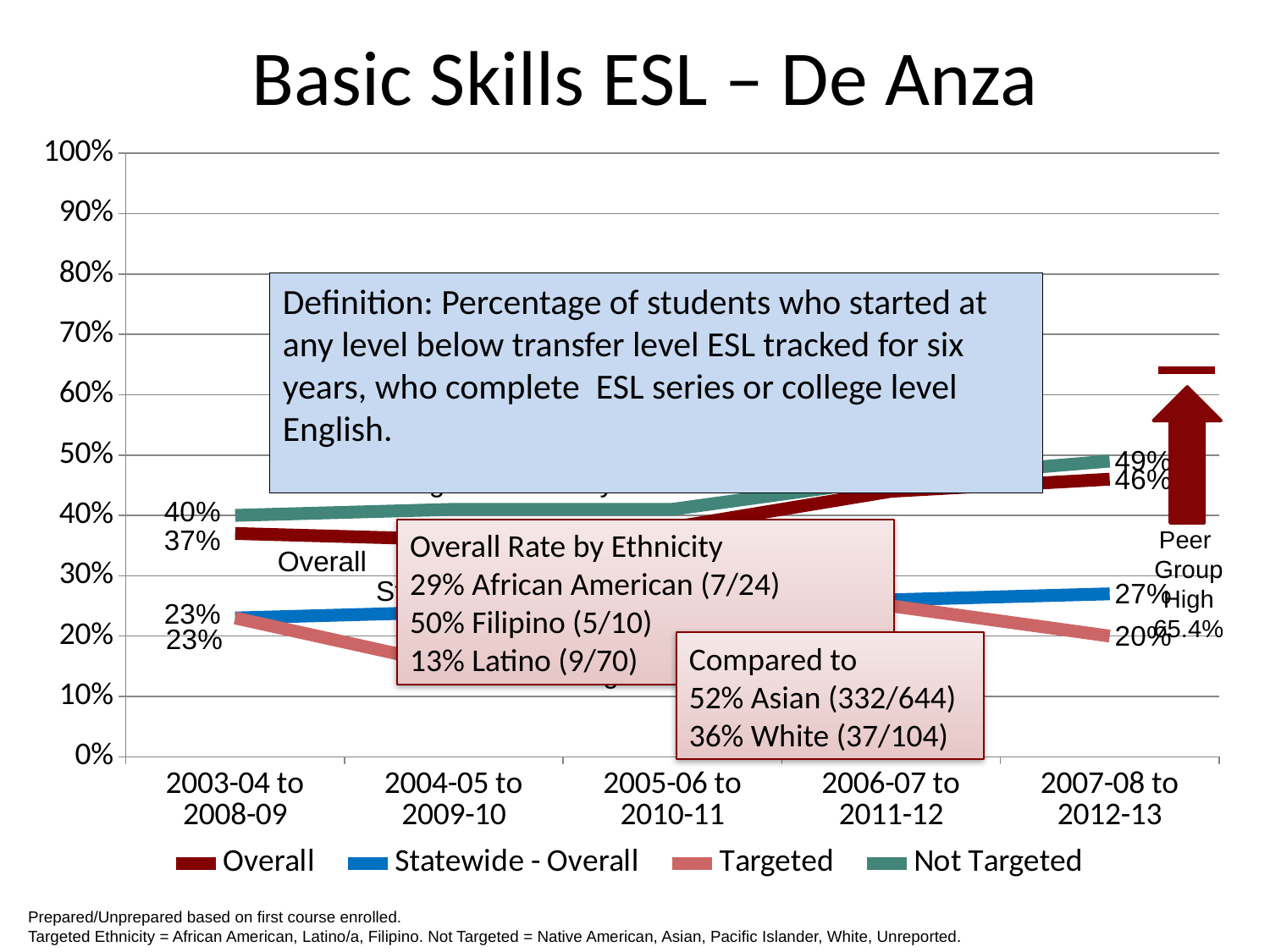
What is the Targeted value for the 2007-08 to 2012-13 cohort? 20% Does the Overall series rise or fall from the first cohort to the last cohort? rises How many series does the legend list? 4 What is the difference between the Not Targeted and Overall values in the 2007-08 to 2012-13 cohort? 3 percentage points What is the Statewide - Overall value for the 2007-08 to 2012-13 cohort? 27% Which series has the highest value in the 2007-08 to 2012-13 cohort? Not Targeted What is the Overall value for the 2007-08 to 2012-13 cohort? 46% What is the Peer Group High value shown on the slide? 65.4% What type of chart is shown on the slide? line chart How many cohort periods are shown along the x axis? 5 Which series has the lowest value in the 2007-08 to 2012-13 cohort? Targeted What is the Not Targeted value for the 2003-04 to 2008-09 cohort? 40%